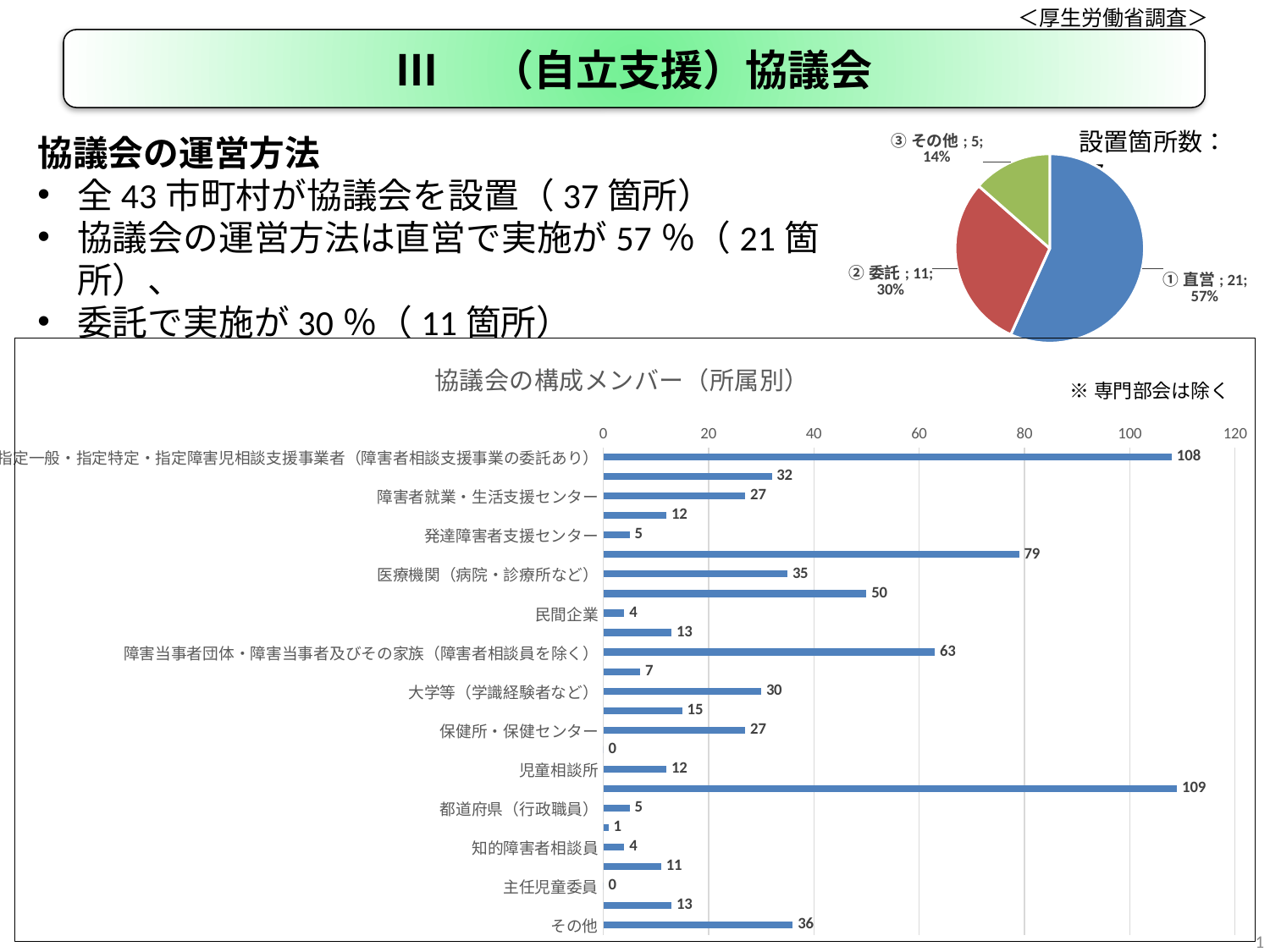
How many slices does the pie chart 設置箇所数 have? 3 In the pie chart 設置箇所数, what is the value for ② 委託? 11 In the chart 協議会の構成メンバー（所属別）, what is the value for 医療機関（病院・診療所など）? 35 In the chart 協議会の構成メンバー（所属別）, what is the difference between the values for 医療機関（病院・診療所など） and 保健所・保健センター? 8 In the pie chart 設置箇所数, which slice is the largest? ① 直営 In the chart 協議会の構成メンバー（所属別）, is the value for 指定一般・指定特定・指定障害児相談支援事業者（障害者相談支援事業の委託あり） greater or less than 100? greater What kind of chart is the chart titled 設置箇所数 at the top right of the slide? pie chart In the chart 協議会の構成メンバー（所属別）, what is the value for 障害当事者団体・障害当事者及びその家族（障害者相談員を除く）? 63 What kind of chart is 協議会の構成メンバー（所属別）? bar chart In the pie chart 設置箇所数, which slice is the smallest? ③ その他 In the chart 協議会の構成メンバー（所属別）, which is larger: 大学等（学識経験者など） or 障害者就業・生活支援センター? 大学等（学識経験者など） In the pie chart 設置箇所数, what percentage share does ① 直営 have? 57%